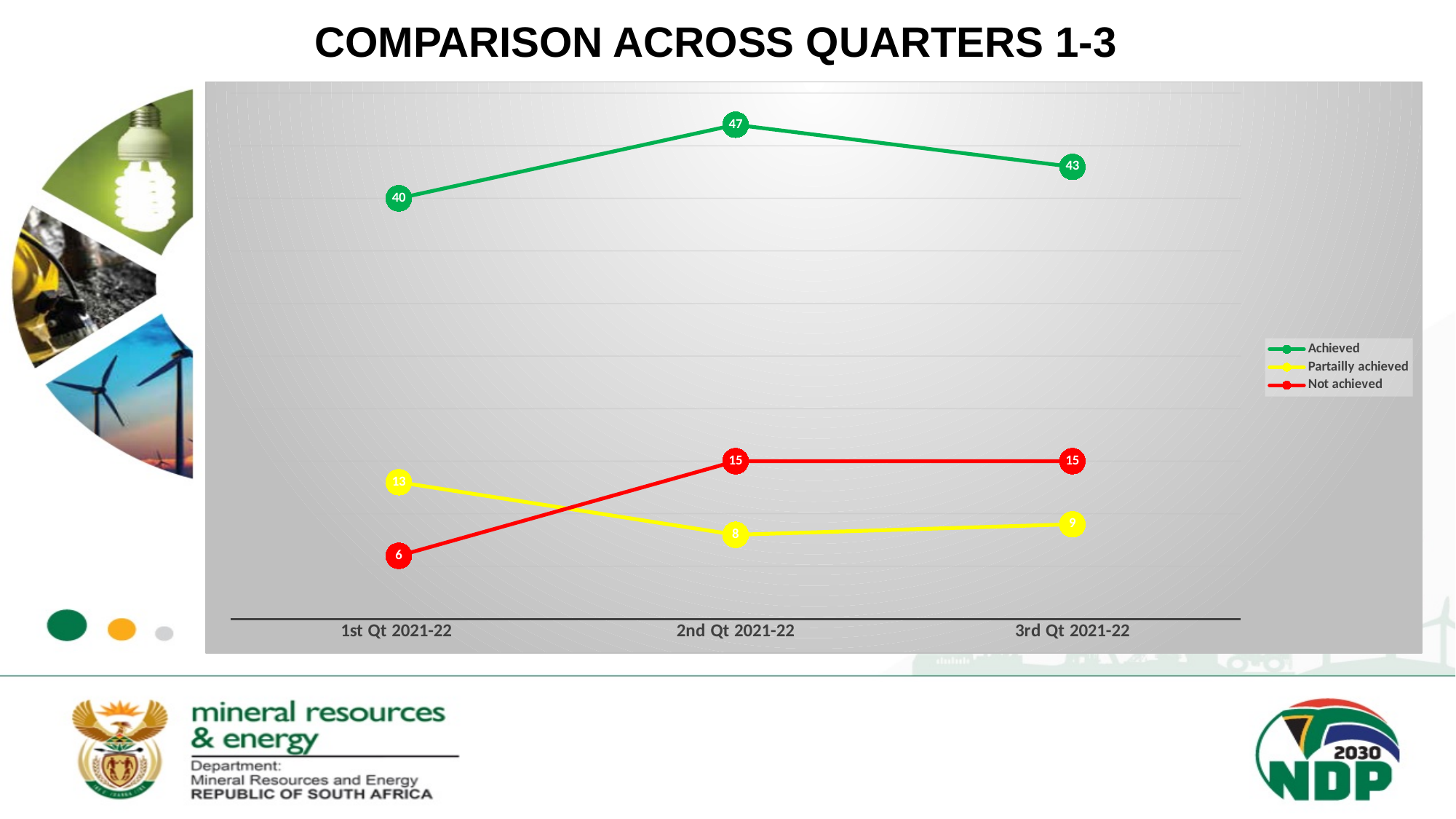
What is the Not achieved value for 1st Qt 2021-22? 6 Which is larger in 1st Qt 2021-22: Partailly achieved or Not achieved? Partailly achieved How many quarters are shown on the x axis? 3 In which quarter is the Achieved value highest? 2nd Qt 2021-22 In which quarter is the Partailly achieved value lowest? 2nd Qt 2021-22 What colour is the Not achieved line? red Does the Not achieved value rise or fall from 1st Qt 2021-22 to 2nd Qt 2021-22? rise What is the difference between the Achieved values for 2nd Qt 2021-22 and 1st Qt 2021-22? 7 What is the Achieved value for 2nd Qt 2021-22? 47 What is the Partailly achieved value for 3rd Qt 2021-22? 9 How many series does the legend list? 3 What kind of chart is shown on the slide? line chart